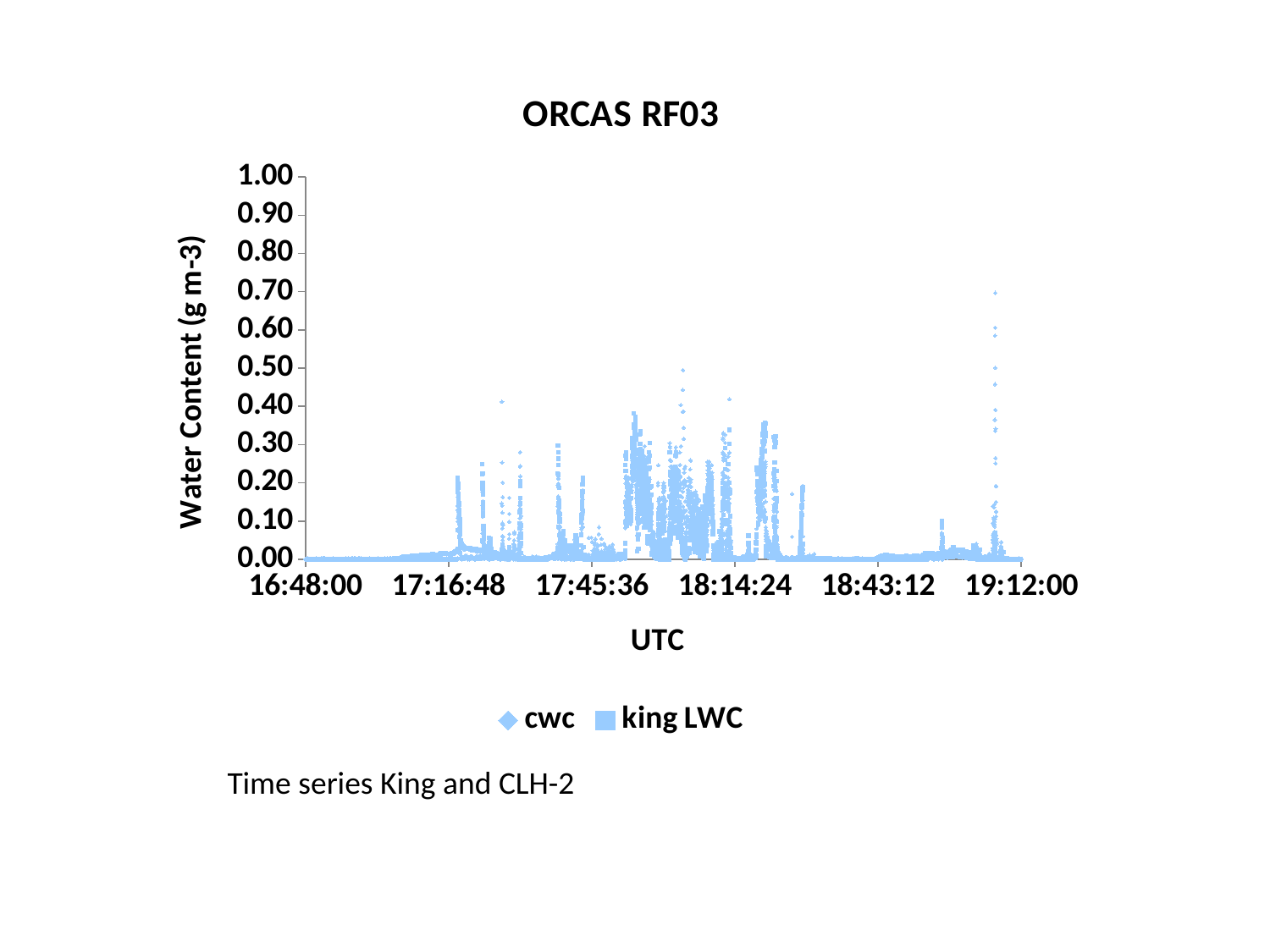
What is the title of the chart? ORCAS RF03 How many tick labels are shown on the x axis? 6 What kind of chart is shown on the slide? Scatter chart Is the highest plotted water content value greater or less than 0.50? greater Is the highest plotted water content value greater or less than 0.80? less What is the label of the y axis? Water Content (g m-3) What is the label of the x axis? UTC What is the last time tick shown on the x axis? 19:12:00 What is the maximum value shown on the y axis? 1.00 What is the first time tick shown on the x axis? 16:48:00 What are the names of the two series in the legend? cwc and king LWC How many series does the legend list? 2